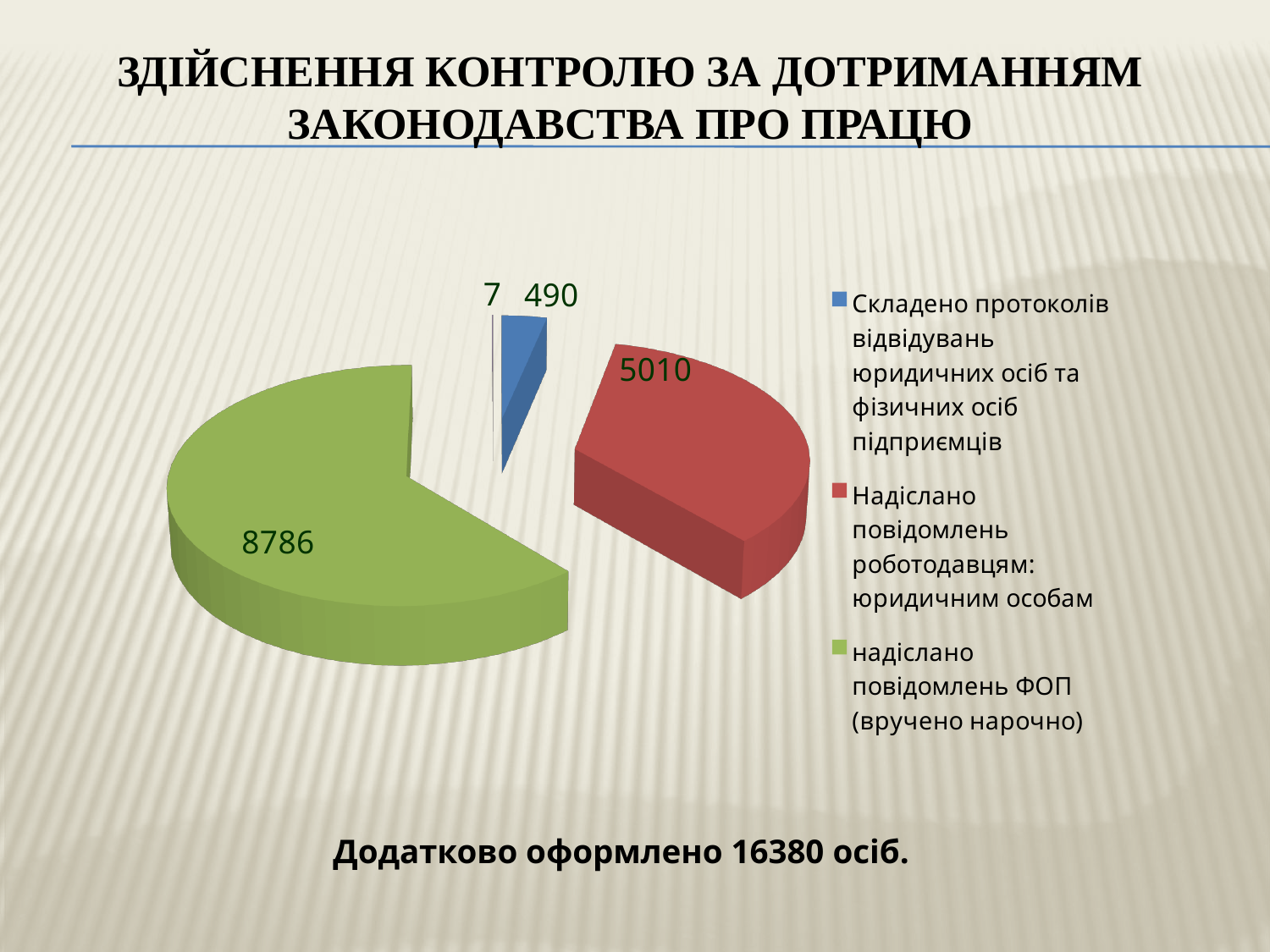
How many entries does the chart legend list? 3 What colour is the slice for "Надіслано повідомлень роботодавцям: юридичним особам"? red What is the difference between the values for "надіслано повідомлень ФОП (вручено нарочно)" and "Надіслано повідомлень роботодавцям: юридичним особам"? 3776 What is the value for "надіслано повідомлень ФОП (вручено нарочно)"? 8786 Which is larger: the value for "Надіслано повідомлень роботодавцям: юридичним особам" or the value for "Складено протоколів відвідувань юридичних осіб та фізичних осіб підприємців"? Надіслано повідомлень роботодавцям: юридичним особам What is the difference between the values for "Надіслано повідомлень роботодавцям: юридичним особам" and "Складено протоколів відвідувань юридичних осіб та фізичних осіб підприємців"? 4520 What kind of chart is shown on the slide? pie chart Which is larger: the value for "надіслано повідомлень ФОП (вручено нарочно)" or the value for "Надіслано повідомлень роботодавцям: юридичним особам"? надіслано повідомлень ФОП (вручено нарочно) What is the value for "Надіслано повідомлень роботодавцям: юридичним особам"? 5010 What colour is the largest slice of the pie? green What is the value for "Складено протоколів відвідувань юридичних осіб та фізичних осіб підприємців"? 490 Which legend category has the largest slice of the pie? надіслано повідомлень ФОП (вручено нарочно)